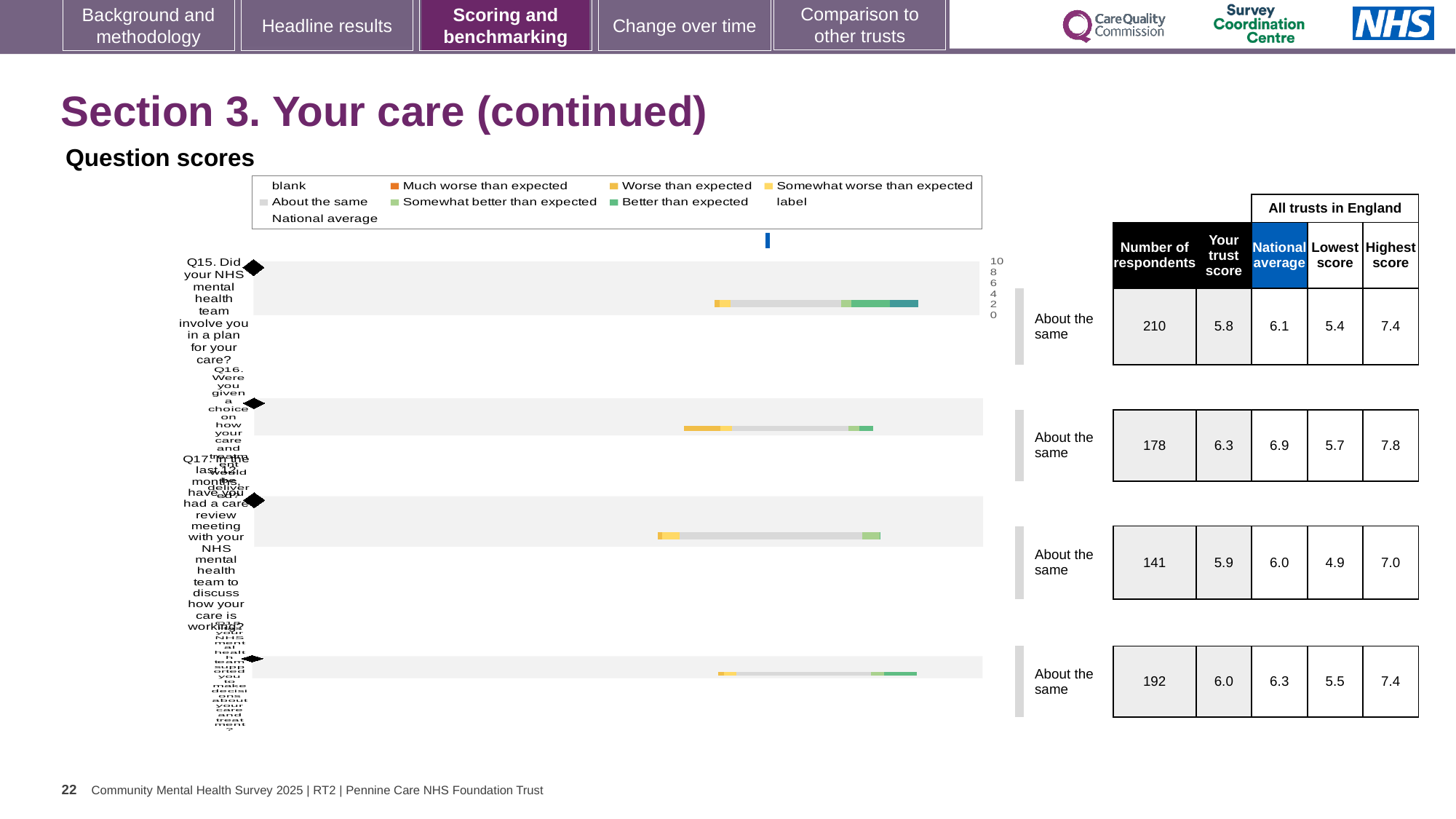
In the table beside the chart, what is the national average for the third row (Q17)? 6.0 How many question bars are plotted in the question scores chart? 4 In the table beside the chart, what is the highest score for the fourth row (Q18)? 7.4 What is the highest tick value shown on the score axis of the question scores chart? 10 In the table beside the chart, what is the number of respondents for the first row (Q15)? 210 What kind of chart is used to show the question scores on this slide? bar chart In the table beside the chart, which row has the lowest 'Lowest score' value? Q17 (4.9) Which legend entry in the question scores chart is shown in orange? Much worse than expected How many entries does the legend of the question scores chart list? 9 In the table beside the chart, what is the trust score for the second row (Q16)? 6.3 In the table beside the chart, is the trust score for Q15 larger or smaller than the national average? smaller In the table beside the chart, what is the difference between the national average and the trust score for Q16? 0.6